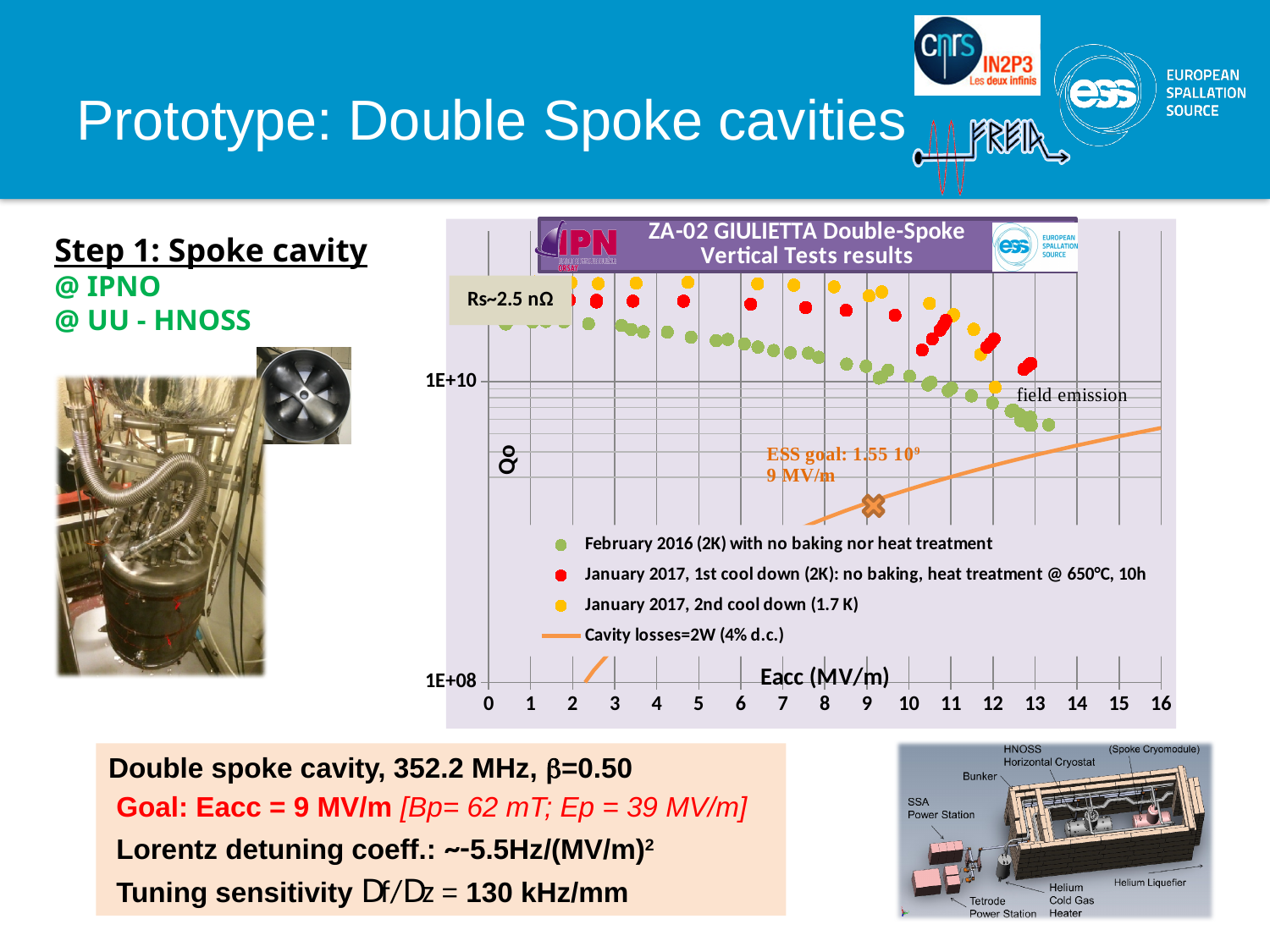
According to the annotation on the chart, what is the ESS goal for Q0 at 9 MV/m? 1.55 10⁹ What is the title of the chart on the slide? ZA-02 GIULIETTA Double-Spoke Vertical Tests results What kind of chart is shown on the slide? scatter plot What surface resistance value is annotated in the top-left of the chart? Rs~2.5 nΩ At Eacc of about 13 MV/m, which series has the higher Q0: January 2017, 2nd cool down (1.7 K) or February 2016 (2K)? January 2017, 2nd cool down (1.7 K) For the February 2016 (2K) series, do the Q0 values rise or fall as Eacc increases? fall Is the Q0 value of the February 2016 (2K) series at Eacc of about 13 MV/m greater or less than 1E+10? less Is the Q0 value of the January 2017, 1st cool down (2K) series at Eacc of about 12 MV/m greater or less than 1E+10? greater What is the label of the x axis of the chart? Eacc (MV/m) How many entries does the chart's legend list? 4 What is the lowest tick value printed on the y axis of the chart? 1E+08 What is the highest value shown on the x axis of the chart? 16